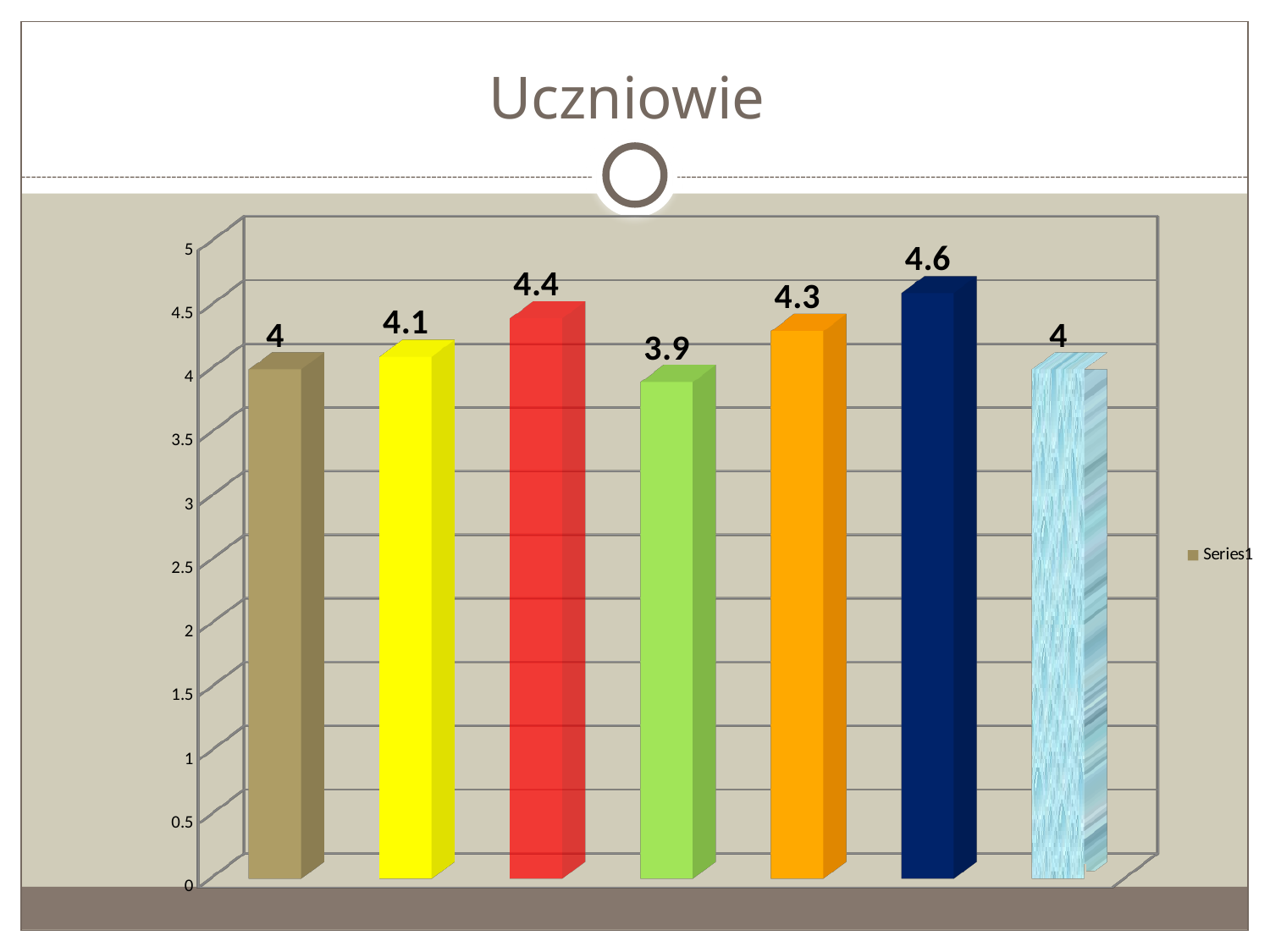
What is the value shown on the dark blue bar? 4.6 Which bar has the highest value? the dark blue bar (4.6) Which bar has the lowest value? the green bar (3.9) Which is larger, the red bar or the orange bar? the red bar What is the difference between the dark blue bar and the green bar? 0.7 What is the value shown on the orange bar? 4.3 What is the value shown on the green bar? 3.9 How many bars are plotted in the chart? 7 How many series does the legend list? 1 What is the value shown on the yellow bar? 4.1 What is the value shown on the red bar? 4.4 What kind of chart is shown on the slide? bar chart